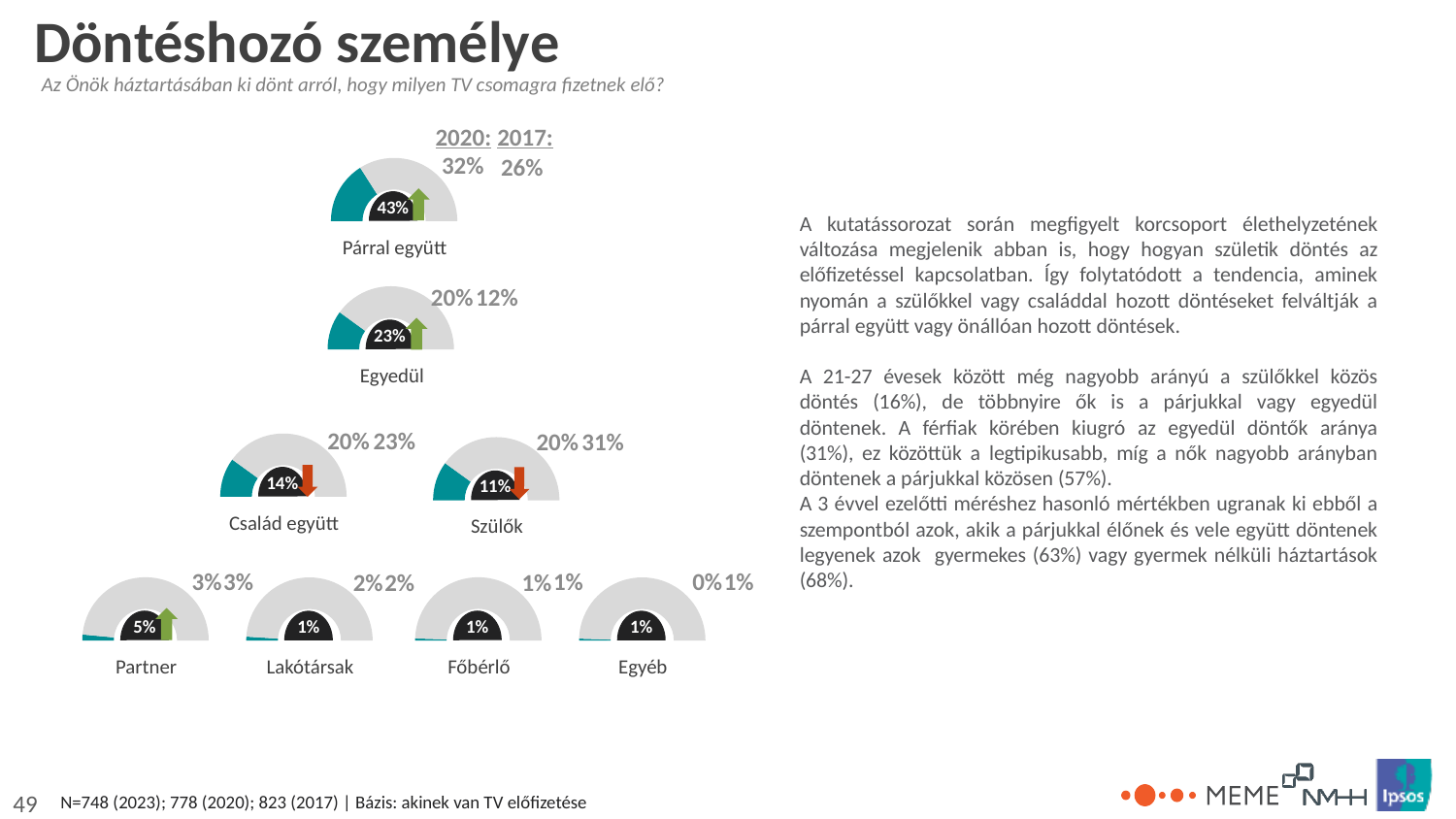
On the 'Egyedül' gauge chart, what value is printed for 2017? 12% On the 'Partner' gauge chart, what is the current value shown in the centre? 5% On the 'Szülők' gauge chart, what is the difference between the 2017 value and the current value? 20% On the 'Család együtt' gauge chart, what is the current value shown in the centre? 14% On the 'Párral együtt' gauge chart, what is the difference between the current value (43%) and the 2017 value (26%)? 17% How many gauge charts are shown on the slide? 8 On the 'Párral együtt' gauge chart, what is the current (2023) value shown in the centre? 43% What kind of chart is used for each category on the slide? Gauge (semi-circle doughnut) chart On the 'Egyéb' gauge chart, what value is printed for 2020? 0% Which category's gauge chart shows the highest current value? Párral együtt Which is larger: the current value on the 'Egyedül' gauge or the current value on the 'Család együtt' gauge? Egyedül On the 'Szülők' gauge chart, what value is printed for 2020? 20%